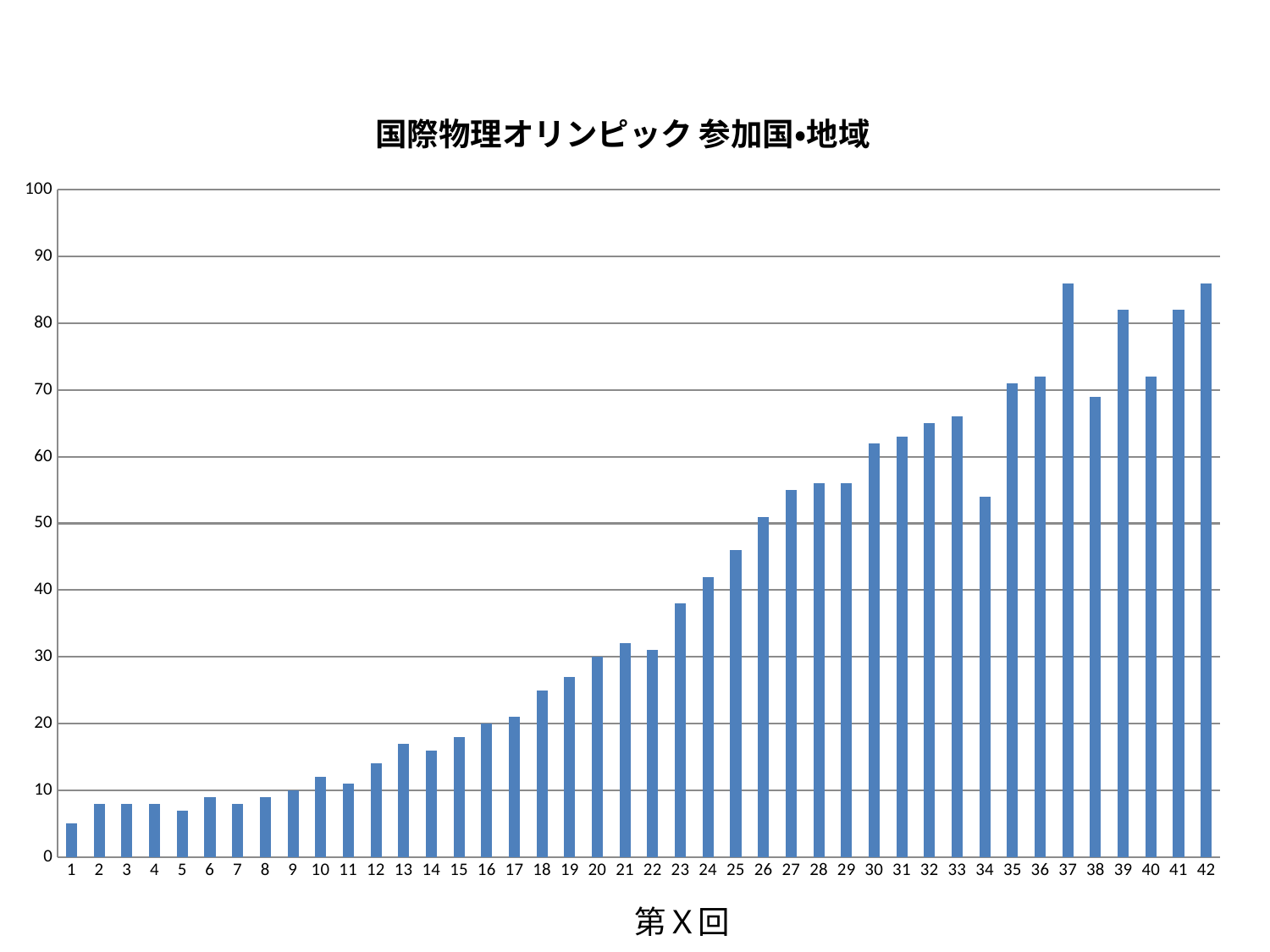
Is the value for category 42 greater or less than 80? greater Do the values generally rise or fall from category 1 to category 42? rise What is the title of the chart? 国際物理オリンピック 参加国•地域 What kind of chart is shown on the slide? bar chart Which has the larger value, category 33 or category 34? 33 How many categories (回) are plotted along the x axis? 42 Is the value for category 1 greater or less than 10? less Which category has the lowest value? 1 Is the value for category 25 greater or less than 50? less What is the label on the x axis of the chart? 第X回 Which has the larger value, category 37 or category 38? 37